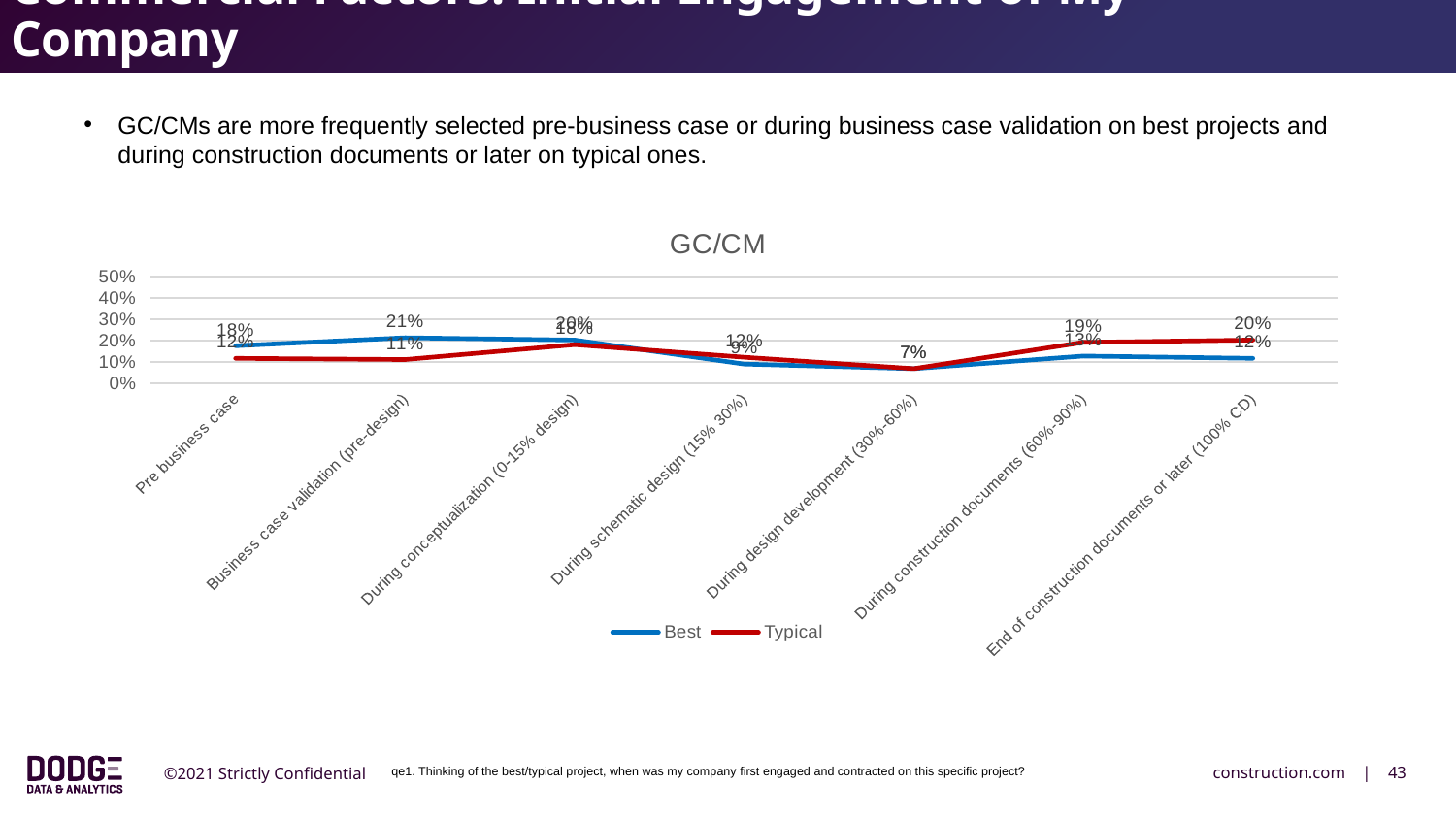
For which category is the Typical series lowest? During design development (30%-60%) At Business case validation (pre-design), which series has the larger value, Best or Typical? Best What is the Typical value for Business case validation (pre-design)? 11% What kind of chart is the GC/CM chart? line chart How many categories are plotted along the x axis of the GC/CM chart? 7 For which category is the Best series highest? Business case validation (pre-design) What is the difference between the Best and Typical values for Business case validation (pre-design)? 10 percentage points What is the Best value for Business case validation (pre-design)? 21% What is the Typical value for During construction documents (60%-90%)? 19% At During construction documents (60%-90%), which series has the larger value, Best or Typical? Typical Is the Best value for During design development (30%-60%) greater or less than 10%? less How many series does the legend of the GC/CM chart list? 2